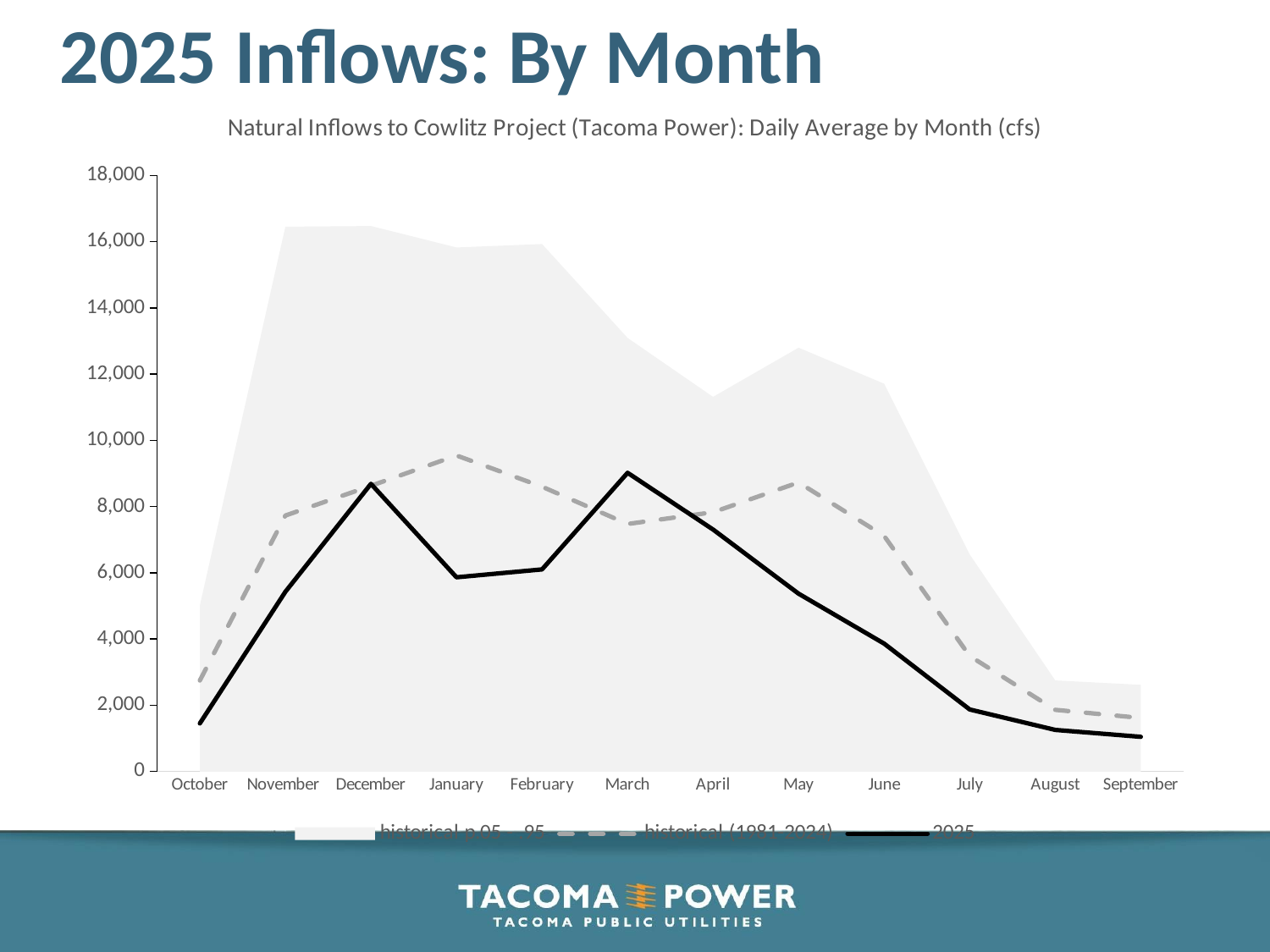
What is the highest value shown on the chart's vertical axis? 18,000 What is the chart's title? Natural Inflows to Cowlitz Project (Tacoma Power): Daily Average by Month (cfs) Is the 2025 value for December greater or less than 8,000? greater Is the 2025 value for October greater or less than 2,000? less Is the 2025 value for May greater or less than 4,000? greater In January, which is higher: the 2025 line or the historical (1981-2024) line? historical (1981-2024) In March, which is higher: the 2025 line or the historical (1981-2024) line? 2025 How many series does the chart's legend list? 3 Does the 2025 line rise or fall from March to September? fall What kind of chart is shown on the slide? combination area and line chart How many months are shown along the x axis of the chart? 12